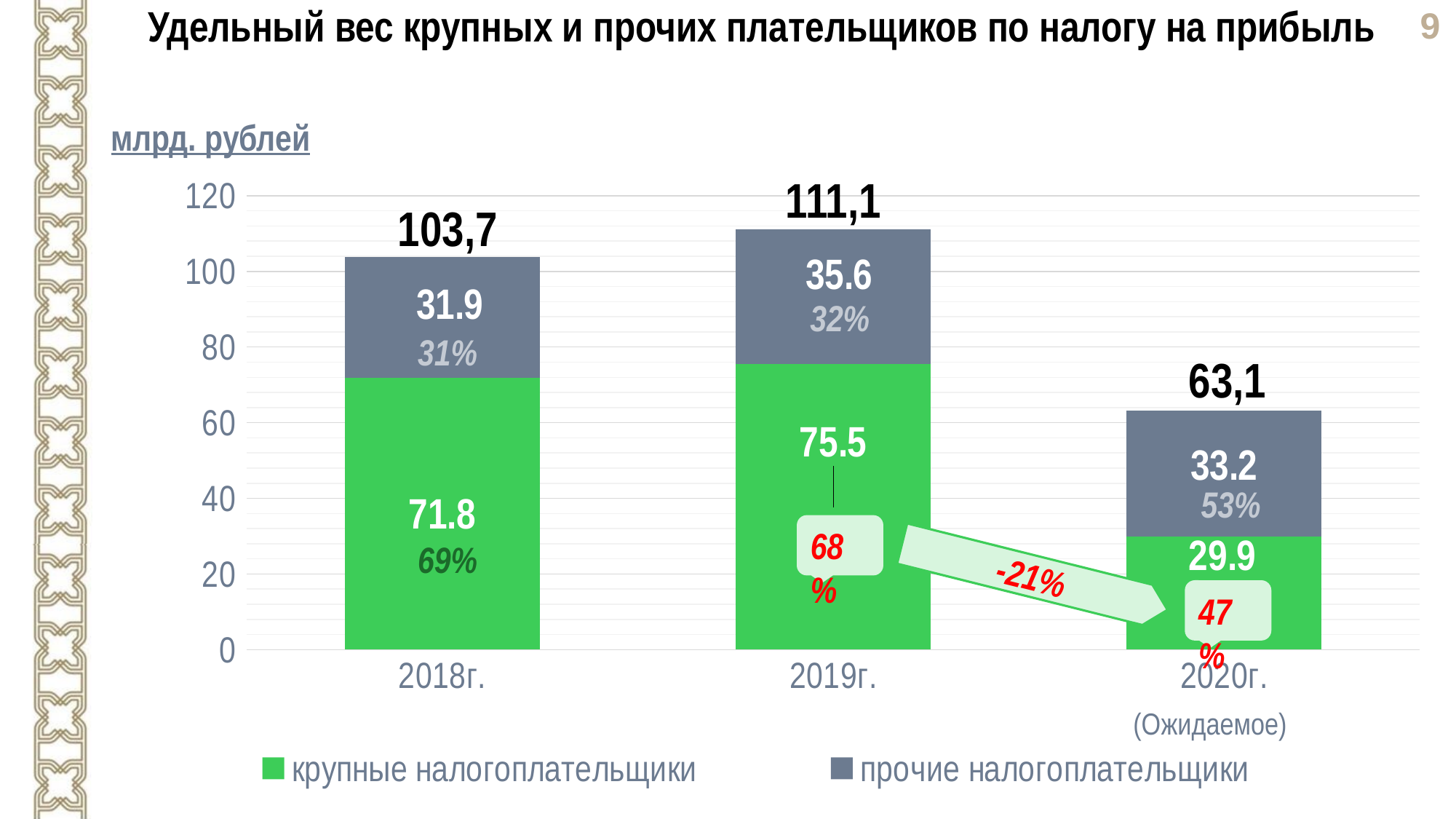
Which year has the lowest value for крупные налогоплательщики? 2020г. How many years are shown on the x axis? 3 Is the total for 2020г. greater or less than 80? less What is the value for прочие налогоплательщики in 2020г.? 33.2 What is the value for крупные налогоплательщики in 2019г.? 75.5 What percentage share is shown for прочие налогоплательщики in 2018г.? 31% What is the total of the stacked bar for 2018г.? 103,7 Which year has the highest total stacked bar? 2019г. Which is larger in 2020г.: крупные налогоплательщики or прочие налогоплательщики? прочие налогоплательщики How many series does the legend list? 2 What is the difference between the крупные налогоплательщики values for 2019г. and 2020г.? 45.6 What kind of chart is shown on the slide? stacked bar chart